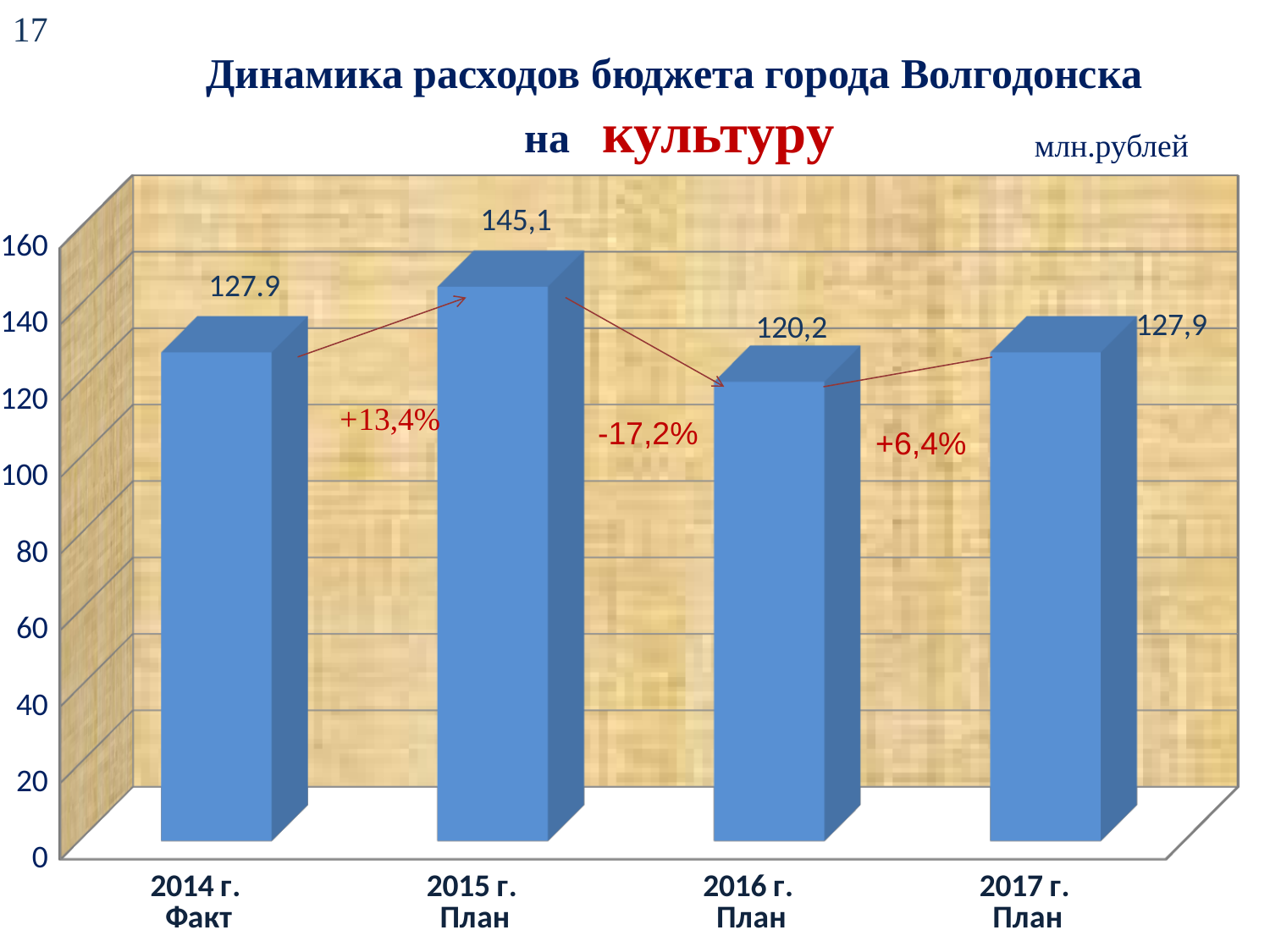
Is the value for 2016 г. План greater or less than 140? less What is the value for 2016 г. План? 120,2 What is the value for 2014 г. Факт? 127.9 Which is larger, the value for 2015 г. План or the value for 2017 г. План? 2015 г. План What is the value for 2017 г. План? 127,9 What is the difference between the values for 2015 г. План and 2016 г. План? 24,9 Which year has the highest value? 2015 г. План How many bars are shown in the chart? 4 What percentage change is shown between 2015 г. План and 2016 г. План? -17,2% Which year has the lowest value? 2016 г. План What is the value for 2015 г. План? 145,1 What kind of chart is shown on the slide? bar chart